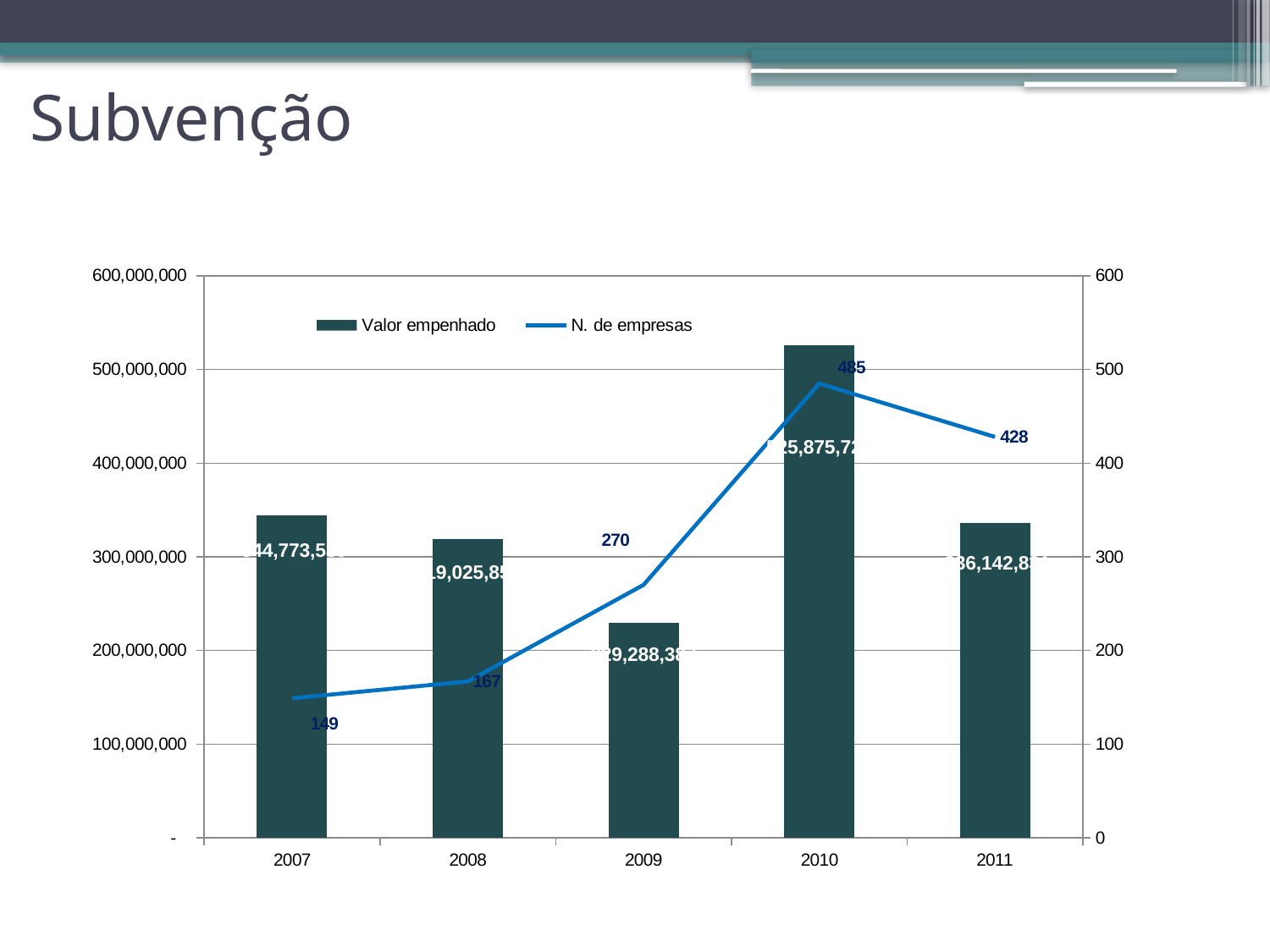
What is the value of N. de empresas in 2011? 428 In which year is N. de empresas lowest? 2007 How many series does the legend list? 2 Is the Valor empenhado for 2009 greater or less than 300,000,000? less Which year has the highest Valor empenhado bar? 2010 How many years are shown on the x axis? 5 By how much did N. de empresas fall from 2010 to 2011? 57 Does N. de empresas rise or fall from 2007 to 2010? rise In which year is N. de empresas highest? 2010 What is the difference in N. de empresas between 2009 and 2008? 103 What is the value of N. de empresas in 2007? 149 What is the value of N. de empresas in 2010? 485